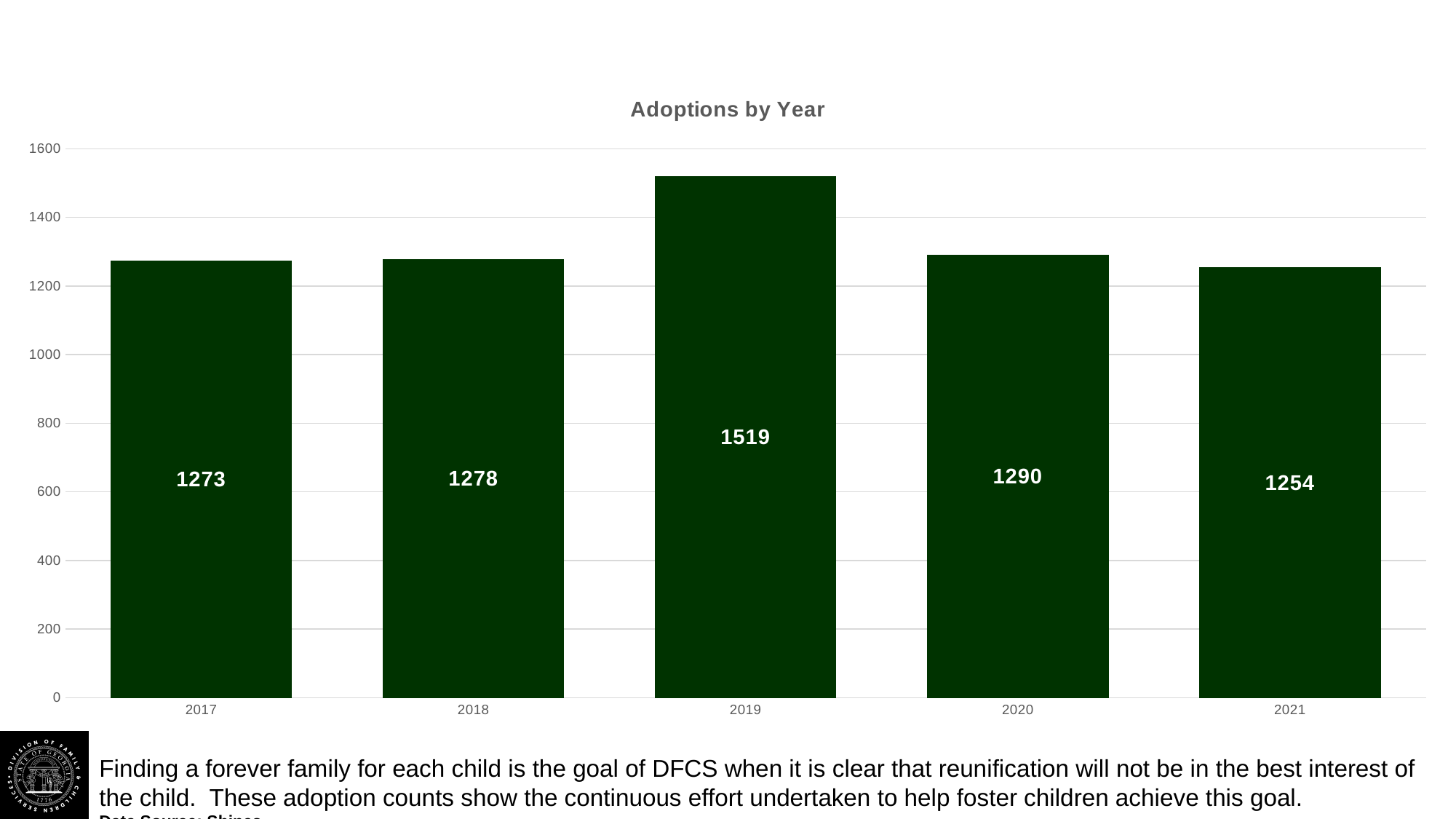
What is the number of adoptions in 2017? 1273 What is the number of adoptions in 2019? 1519 How many years are shown on the chart? 5 Is the value for 2019 greater or less than 1400? greater What kind of chart is shown on the slide? Bar chart Which year had more adoptions, 2020 or 2021? 2020 What is the difference between the adoptions in 2018 and 2017? 5 What is the title of the chart? Adoptions by Year Which year has the lowest number of adoptions? 2021 What is the number of adoptions in 2021? 1254 Which year has the highest number of adoptions? 2019 What is the difference between the adoptions in 2019 and 2020? 229